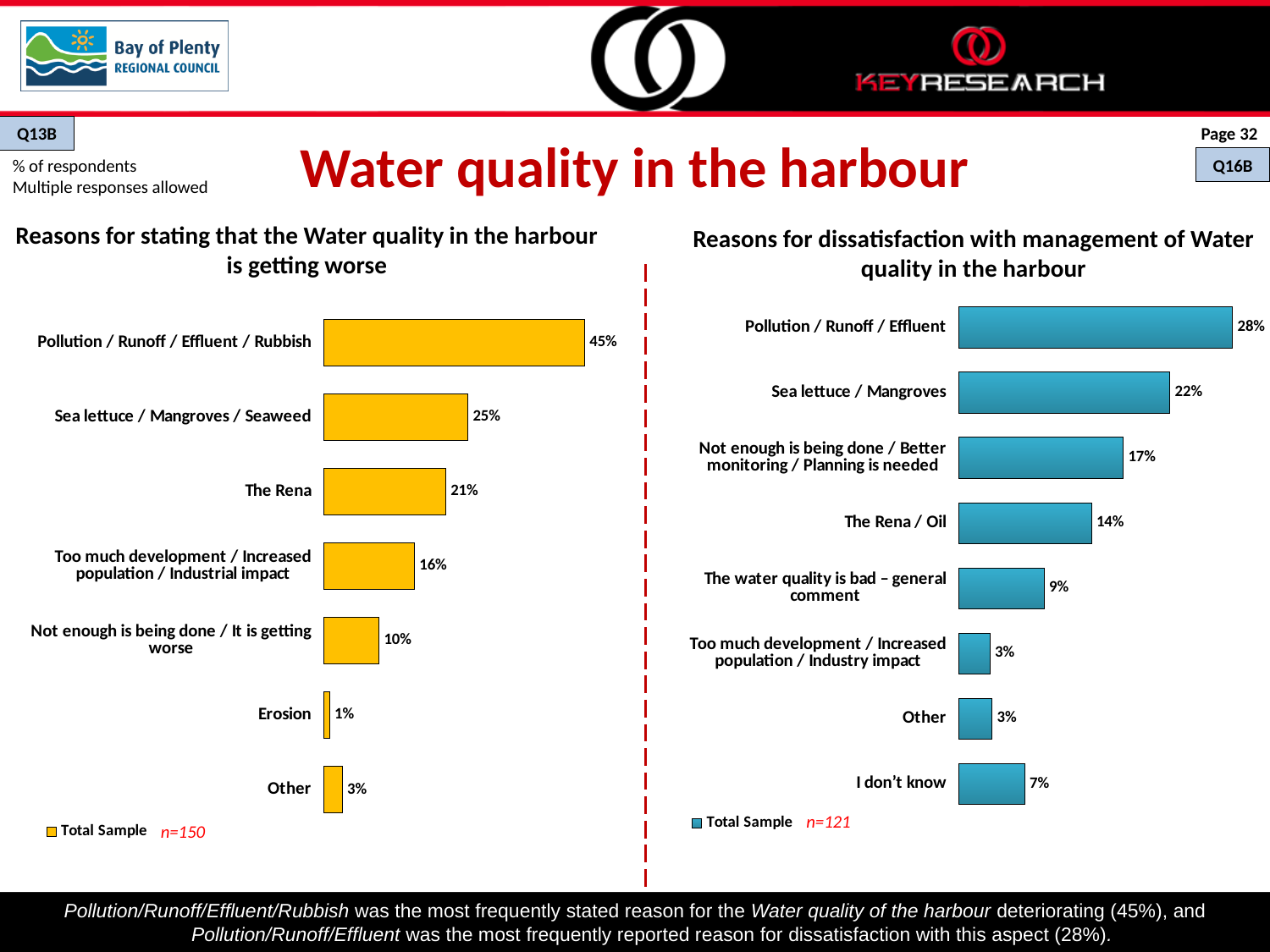
What kind of chart is the chart 'Reasons for dissatisfaction with management of Water quality in the harbour'? Bar chart In the chart 'Reasons for dissatisfaction with management of Water quality in the harbour', which is larger: The water quality is bad – general comment or I don't know? The water quality is bad – general comment In the chart 'Reasons for dissatisfaction with management of Water quality in the harbour', what is the value for The Rena / Oil? 14% In the chart 'Reasons for stating that the Water quality in the harbour is getting worse', what is the value for Sea lettuce / Mangroves / Seaweed? 25% In the chart 'Reasons for stating that the Water quality in the harbour is getting worse', which category has the lowest value? Erosion What is the sample size (n) shown for the chart 'Reasons for stating that the Water quality in the harbour is getting worse'? n=150 In the chart 'Reasons for stating that the Water quality in the harbour is getting worse', which category has the highest value? Pollution / Runoff / Effluent / Rubbish In the chart 'Reasons for dissatisfaction with management of Water quality in the harbour', what is the difference between Sea lettuce / Mangroves and Not enough is being done / Better monitoring / Planning is needed? 5% How many categories are shown in the chart 'Reasons for dissatisfaction with management of Water quality in the harbour'? 8 In the chart 'Reasons for dissatisfaction with management of Water quality in the harbour', which category has the highest value? Pollution / Runoff / Effluent How many categories are shown in the chart 'Reasons for stating that the Water quality in the harbour is getting worse'? 7 In the chart 'Reasons for stating that the Water quality in the harbour is getting worse', what is the difference between Pollution / Runoff / Effluent / Rubbish and The Rena? 24%